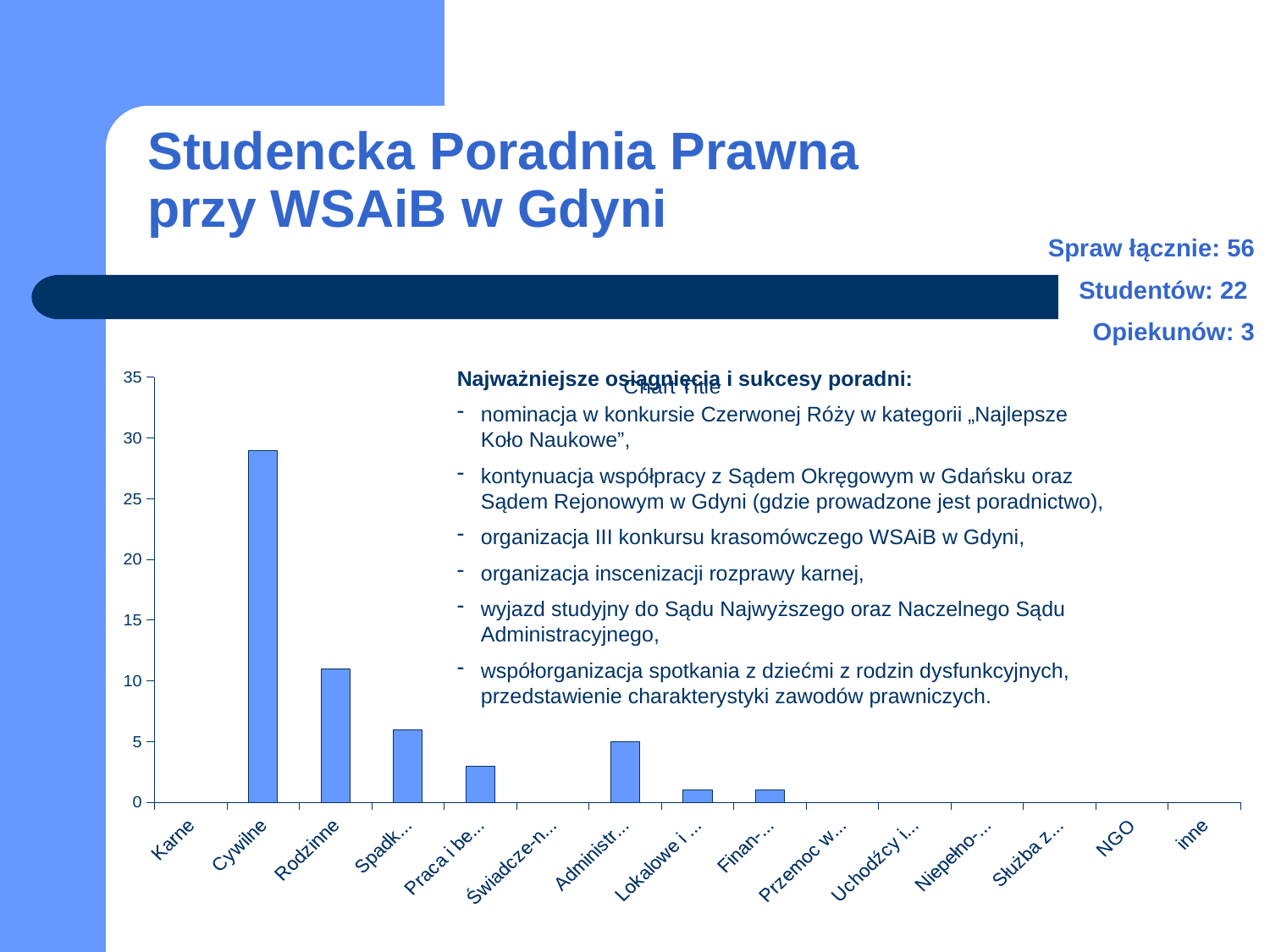
Which is larger, the value for Praca i be... or the value for Administr...? Administr... Is the value for Rodzinne greater or less than 10? greater What kind of chart is shown on the slide? bar chart Is the value for Spadk... greater or less than 10? less How many categories are shown on the x axis of the chart? 15 Which is larger, the value for Rodzinne or the value for Spadk...? Rodzinne Which category has the highest bar in the chart? Cywilne What is the title shown above the chart? Chart Title Which is larger, the value for Cywilne or the value for Rodzinne? Cywilne Is the value for Cywilne greater or less than 25? greater What colour are the bars in the chart? blue